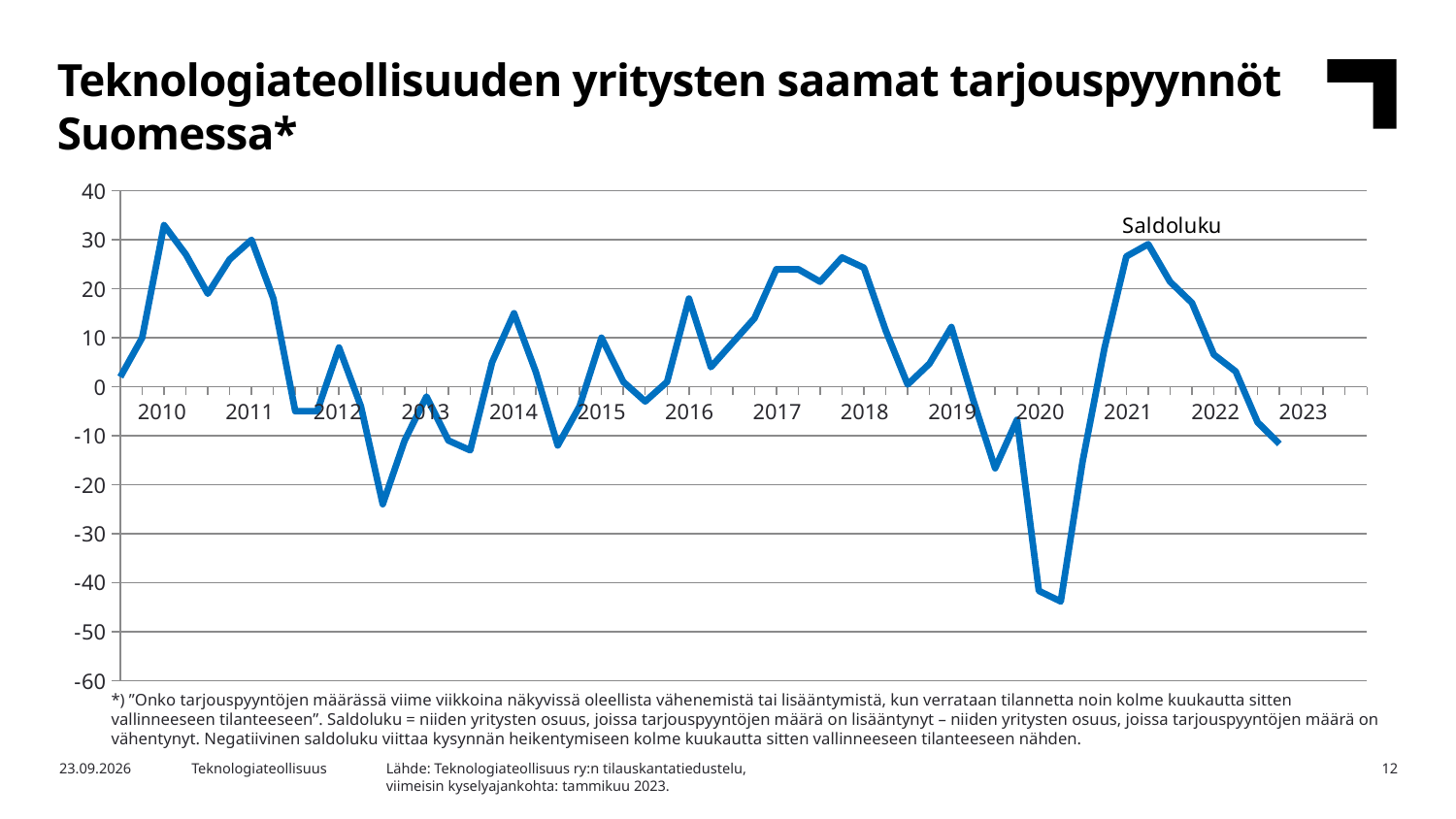
Is the lowest value in 2020 greater or less than -40? less How many year labels are shown on the x axis? 14 Is the peak value in 2021 greater or less than 20? greater In which year does the line reach its lowest value? 2020 Which is lower, the lowest point in 2020 or the lowest point in 2012? 2020 What is the name of the series shown in the chart? Saldoluku Is the lowest value between 2012 and 2013 greater or less than -20? less Do the values rise or fall from the 2021 peak to the end of the series in 2023? fall What is the title of the chart? Teknologiateollisuuden yritysten saamat tarjouspyynnöt Suomessa* How many series does the chart plot? 1 What kind of chart is shown on the slide? line chart